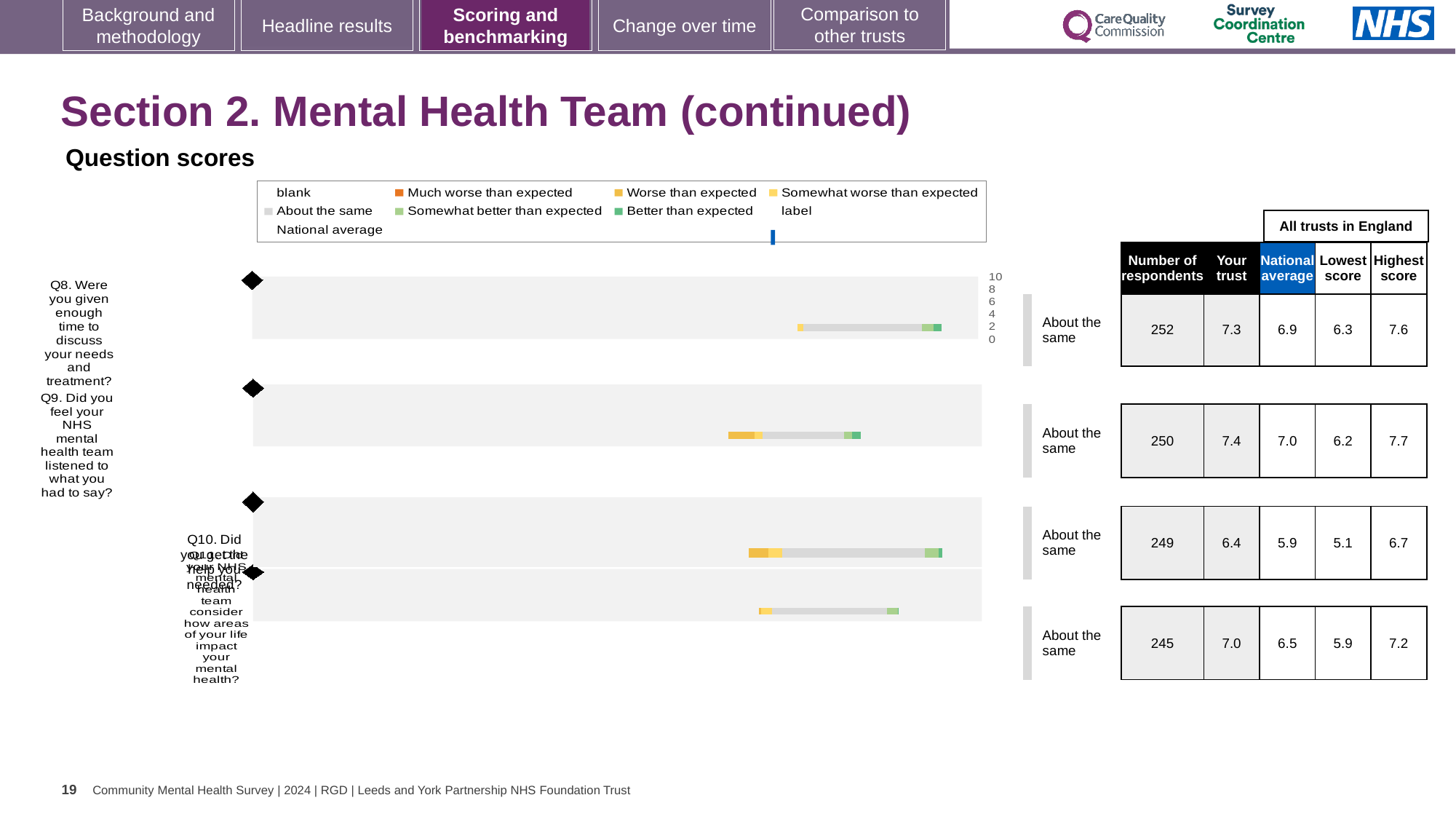
What is the number of respondents for Q8 (Were you given enough time to discuss your needs and treatment?)? 252 What benchmark category is shown for Q8 next to the chart? About the same For Q8, how much higher is the 'Your trust' score than the national average? 0.4 What is the lowest score among all trusts in England for Q10? 5.1 Which question has the lowest 'Your trust' score? Q10 What is the 'Your trust' score for Q9 (Did you feel your NHS mental health team listened to what you had to say?)? 7.4 What kind of chart is used to show the question scores on this slide? bar chart What is the highest score among all trusts in England for Q11? 7.2 How many questions (bars) are plotted in the question scores chart? 4 For Q9, which is larger: the 'Your trust' score or the national average? Your trust Which question has the highest 'Your trust' score? Q9 What is the national average score for Q10 (Did you get the help you needed?)? 5.9